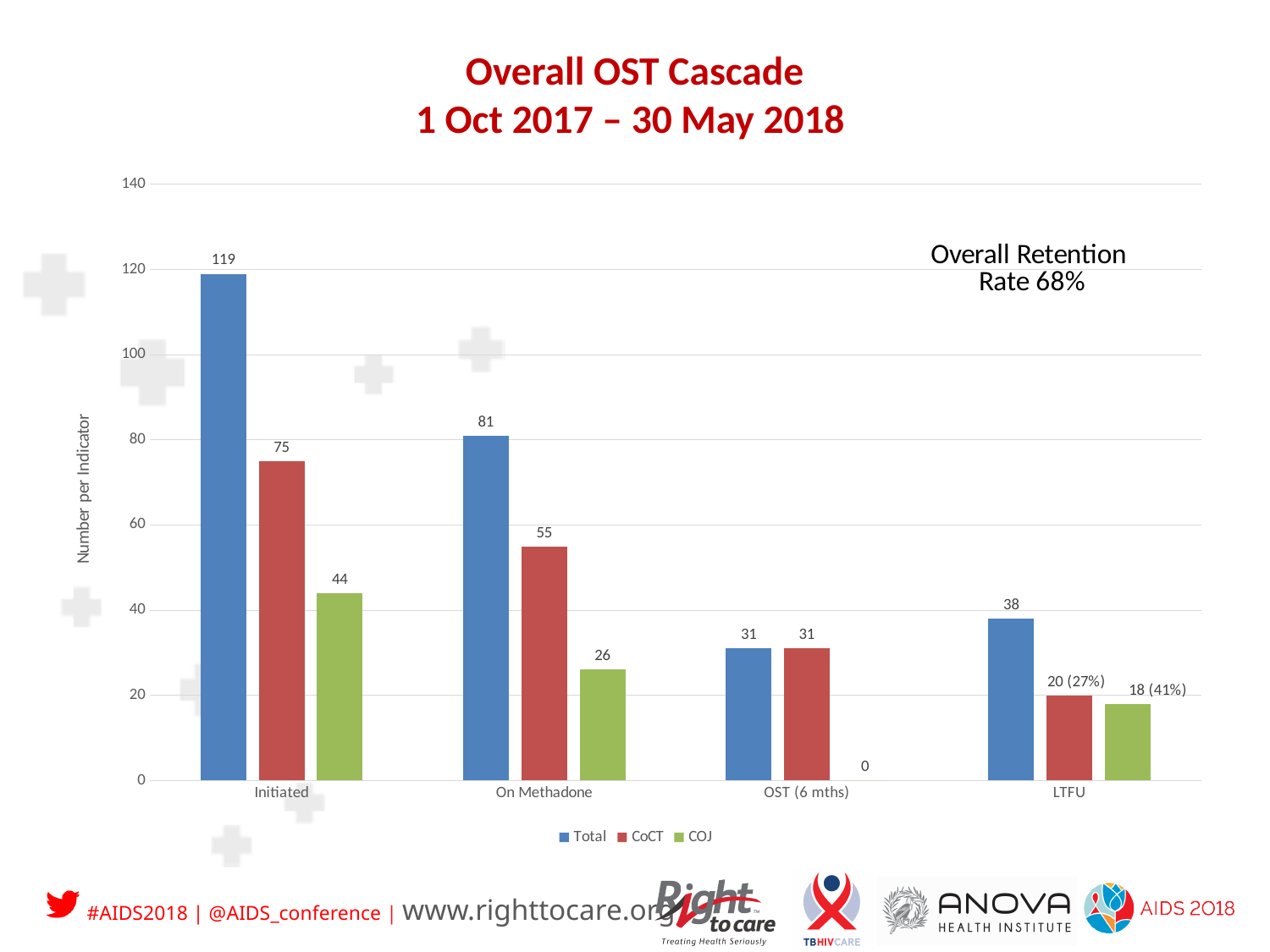
Which category has the lowest COJ value? OST (6 mths) What overall retention rate is stated on the chart? 68% What is the data label on the CoCT bar for LTFU? 20 (27%) What is the CoCT value for On Methadone? 55 How many categories are shown on the x axis? 4 How many series does the legend list? 3 What is the difference between the Total and CoCT values for Initiated? 44 What is the Total value for Initiated? 119 Which category has the highest Total value? Initiated What kind of chart is shown on the slide? Bar chart Which is larger for On Methadone: the CoCT value or the COJ value? CoCT What is the COJ value for OST (6 mths)? 0